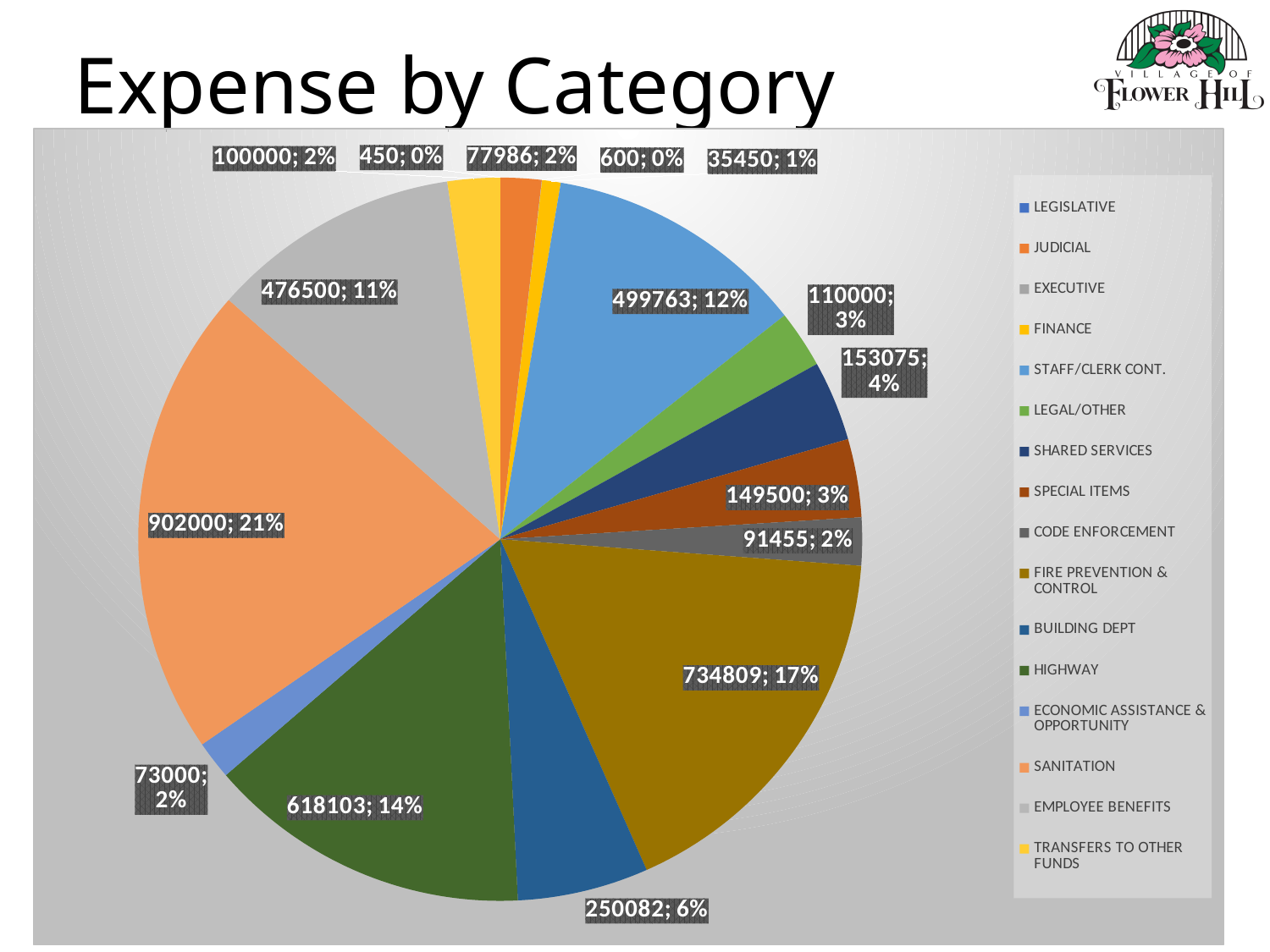
What is the title of the chart? Expense by Category What is the expense value for Building Dept? 250082 What share of the pie does Sanitation represent? 21% Which category has the largest expense? Sanitation What is the expense value for Staff/Clerk Cont.? 499763 How many categories does the legend list? 16 What is the expense value for Sanitation? 902000 Which is larger, the expense for Highway or for Fire Prevention & Control? Fire Prevention & Control What type of chart is shown on the slide? pie chart What percentage of the pie is Highway? 14% What is the difference between the Sanitation expense and the Fire Prevention & Control expense? 167191 What is the expense value for Fire Prevention & Control? 734809